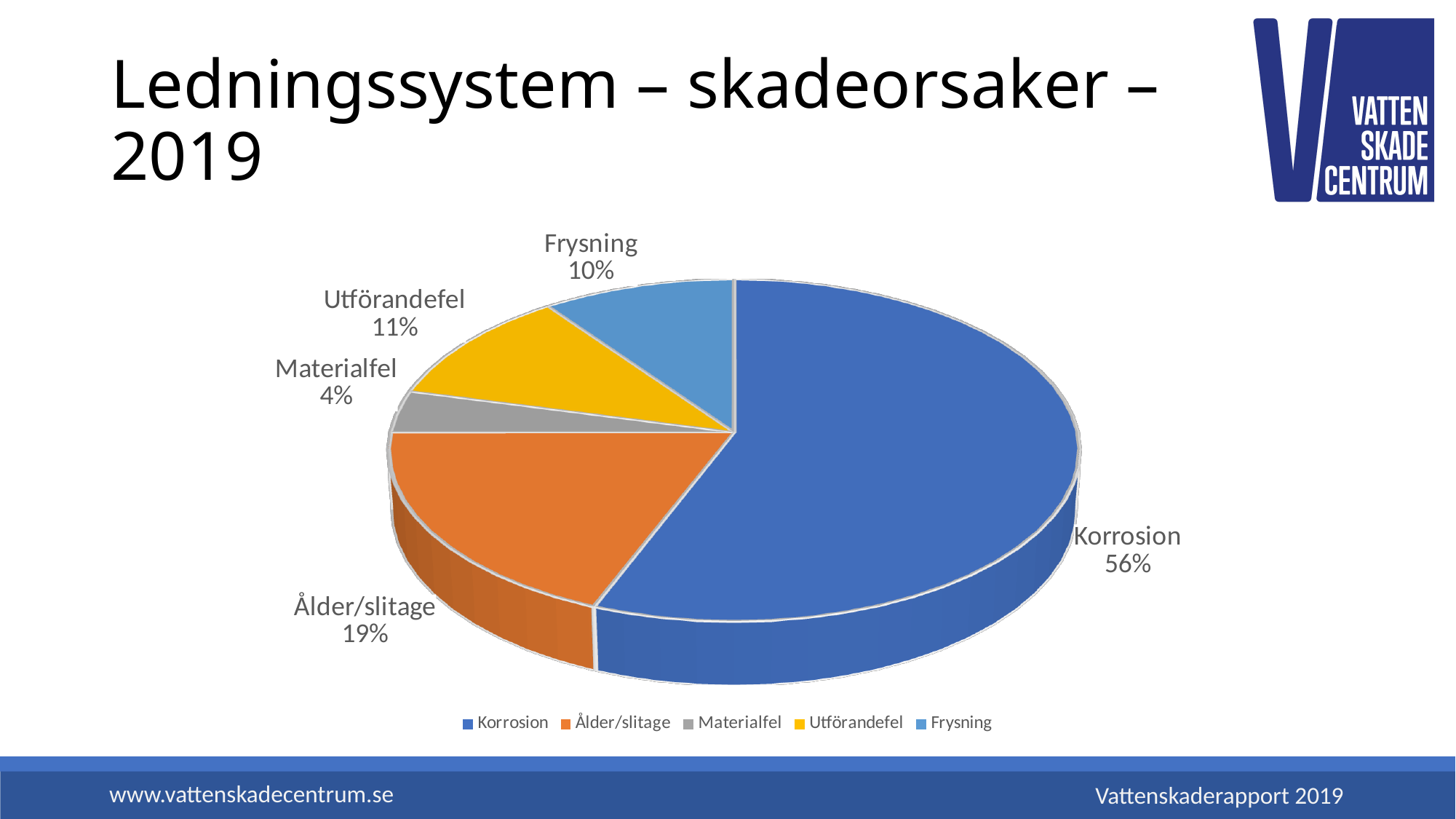
What kind of chart is shown on the slide? Pie chart What share of the pie does Korrosion account for? 56% How many categories are shown in the pie chart? 5 What is the value shown for Ålder/slitage? 19% Which is larger, Utförandefel or Frysning? Utförandefel Which category has the smallest slice of the pie? Materialfel What is the value shown for Frysning? 10% What colour is the Utförandefel slice? Yellow Which category has the largest slice of the pie? Korrosion What is the value shown for Utförandefel? 11% What is the value shown for Materialfel? 4% What is the difference in percentage points between Korrosion and Ålder/slitage? 37